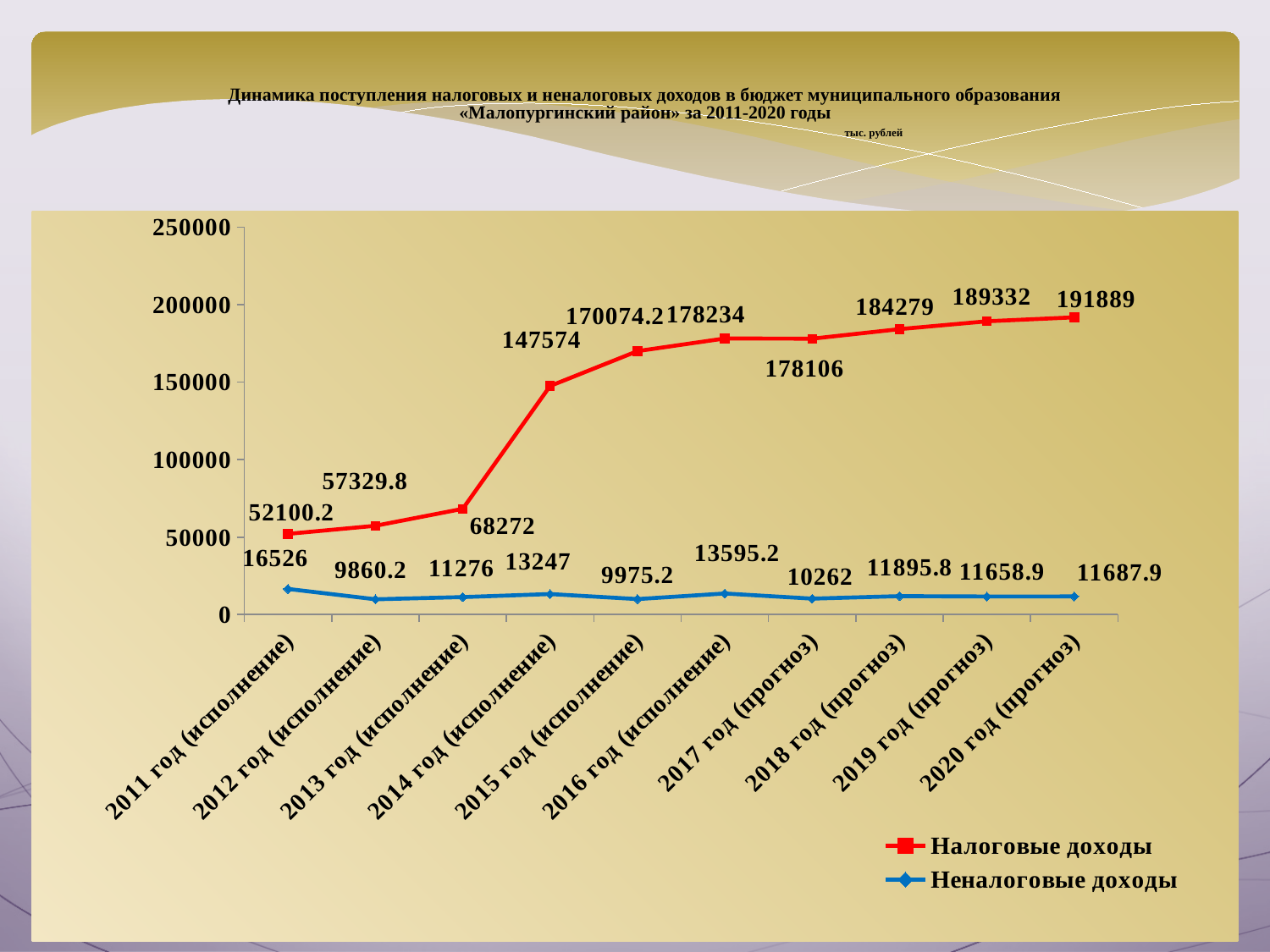
How many series does the legend list? 2 What colour is the line for Неналоговые доходы? blue What is the value of Налоговые доходы for 2014 год (исполнение)? 147574 How many years (categories) are plotted on the x axis? 10 What type of chart is shown on the slide? line chart In which year is Неналоговые доходы highest? 2011 год (исполнение) What is the value of Неналоговые доходы for 2016 год (исполнение)? 13595.2 Which is larger: Неналоговые доходы in 2012 год (исполнение) or in 2013 год (исполнение)? 2013 год (исполнение) What is the difference between Налоговые доходы in 2014 год (исполнение) and 2013 год (исполнение)? 79302 Does Налоговые доходы generally rise or fall from 2011 to 2020? rise In which year is Налоговые доходы lowest? 2011 год (исполнение) What is the value of Налоговые доходы for 2020 год (прогноз)? 191889